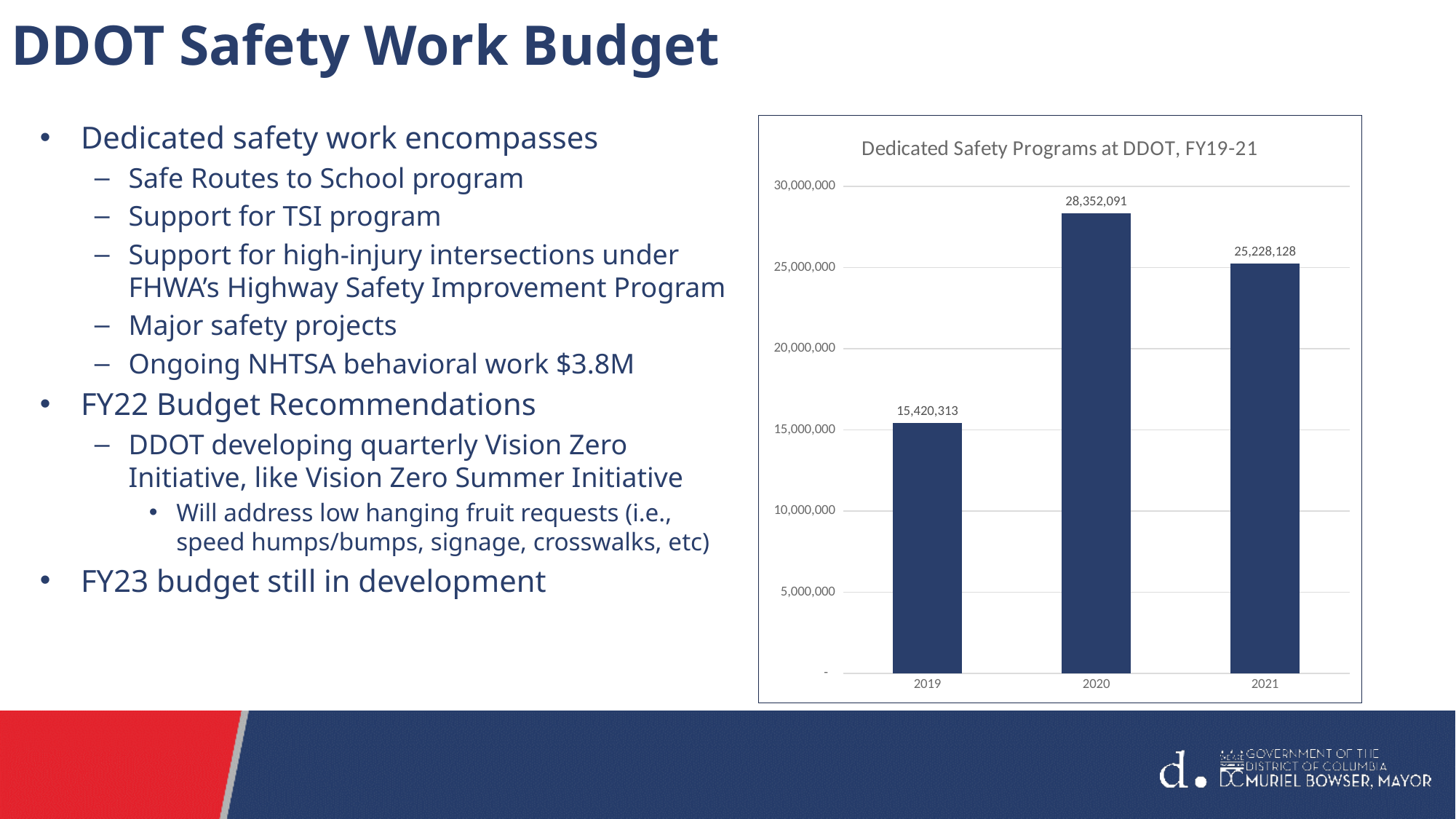
What is the value for 2020 in the Dedicated Safety Programs at DDOT, FY19-21 chart? 28,352,091 Does the value rise or fall from 2020 to 2021 in the Dedicated Safety Programs at DDOT, FY19-21 chart? fall Which is larger in the Dedicated Safety Programs at DDOT, FY19-21 chart, the value for 2021 or the value for 2019? 2021 What kind of chart is the Dedicated Safety Programs at DDOT, FY19-21 chart? bar chart What is the difference between the 2020 and 2019 values in the Dedicated Safety Programs at DDOT, FY19-21 chart? 12,931,778 What is the value for 2021 in the Dedicated Safety Programs at DDOT, FY19-21 chart? 25,228,128 Is the value for 2021 in the Dedicated Safety Programs at DDOT, FY19-21 chart greater or less than 25,000,000? greater What is the difference between the 2020 and 2021 values in the Dedicated Safety Programs at DDOT, FY19-21 chart? 3,123,963 Which year has the highest value in the Dedicated Safety Programs at DDOT, FY19-21 chart? 2020 What is the value for 2019 in the Dedicated Safety Programs at DDOT, FY19-21 chart? 15,420,313 Which year has the lowest value in the Dedicated Safety Programs at DDOT, FY19-21 chart? 2019 How many years are shown in the Dedicated Safety Programs at DDOT, FY19-21 chart? 3